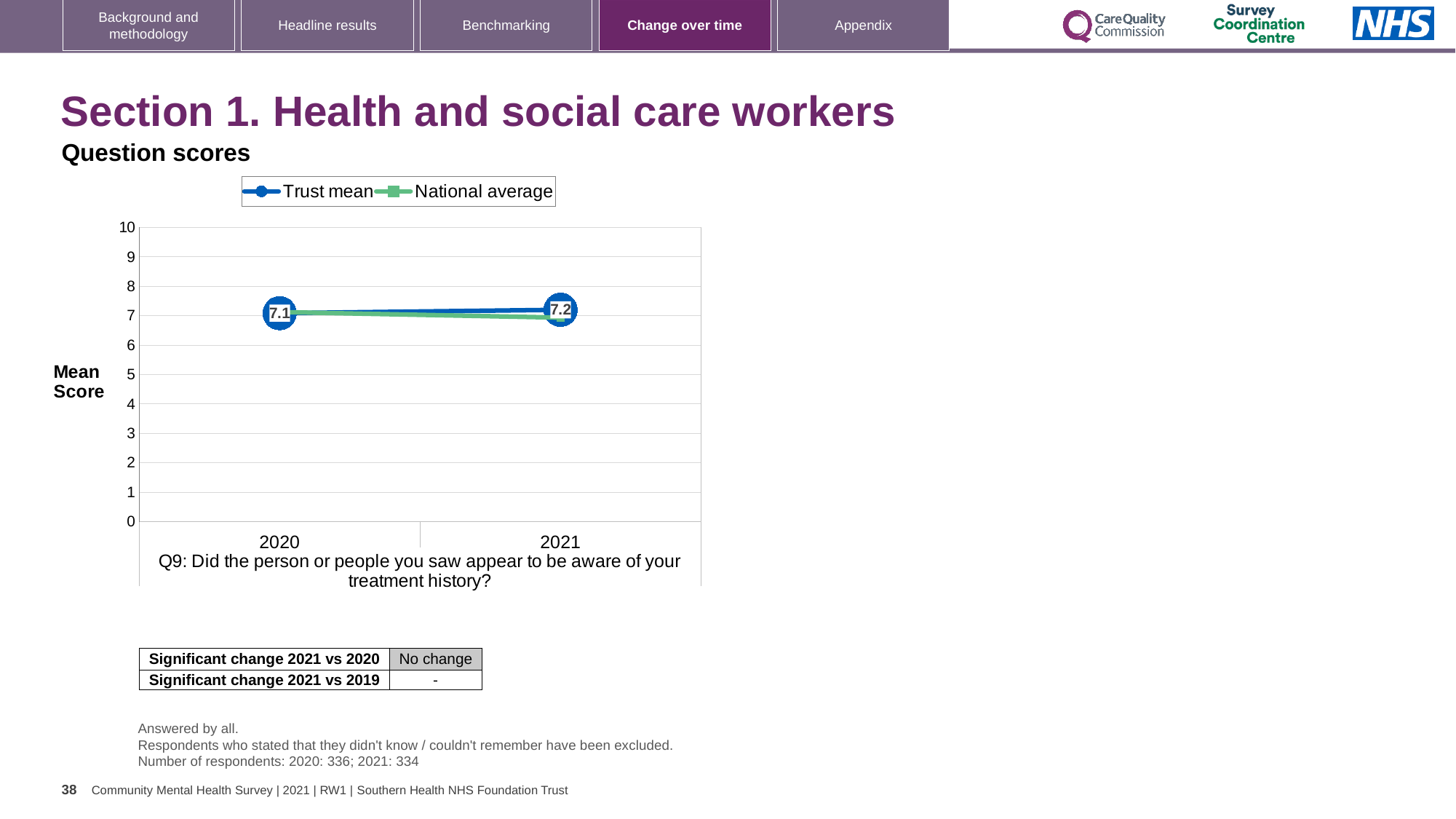
Does the Trust mean rise or fall from 2020 to 2021? Rise Which year has the higher Trust mean score, 2020 or 2021? 2021 What is the Trust mean score for 2020? 7.1 How many years are shown on the x axis of the chart? 2 What is the Trust mean score for 2021? 7.2 By how much did the Trust mean change from 2020 to 2021? 0.1 What are the two series named in the chart legend? Trust mean and National average Is the National average for 2020 greater or less than 5? greater Is the National average for 2021 greater or less than 8? less What type of chart is shown on the slide? Line chart What is the label on the y axis of the chart? Mean Score How many series does the chart legend list? 2